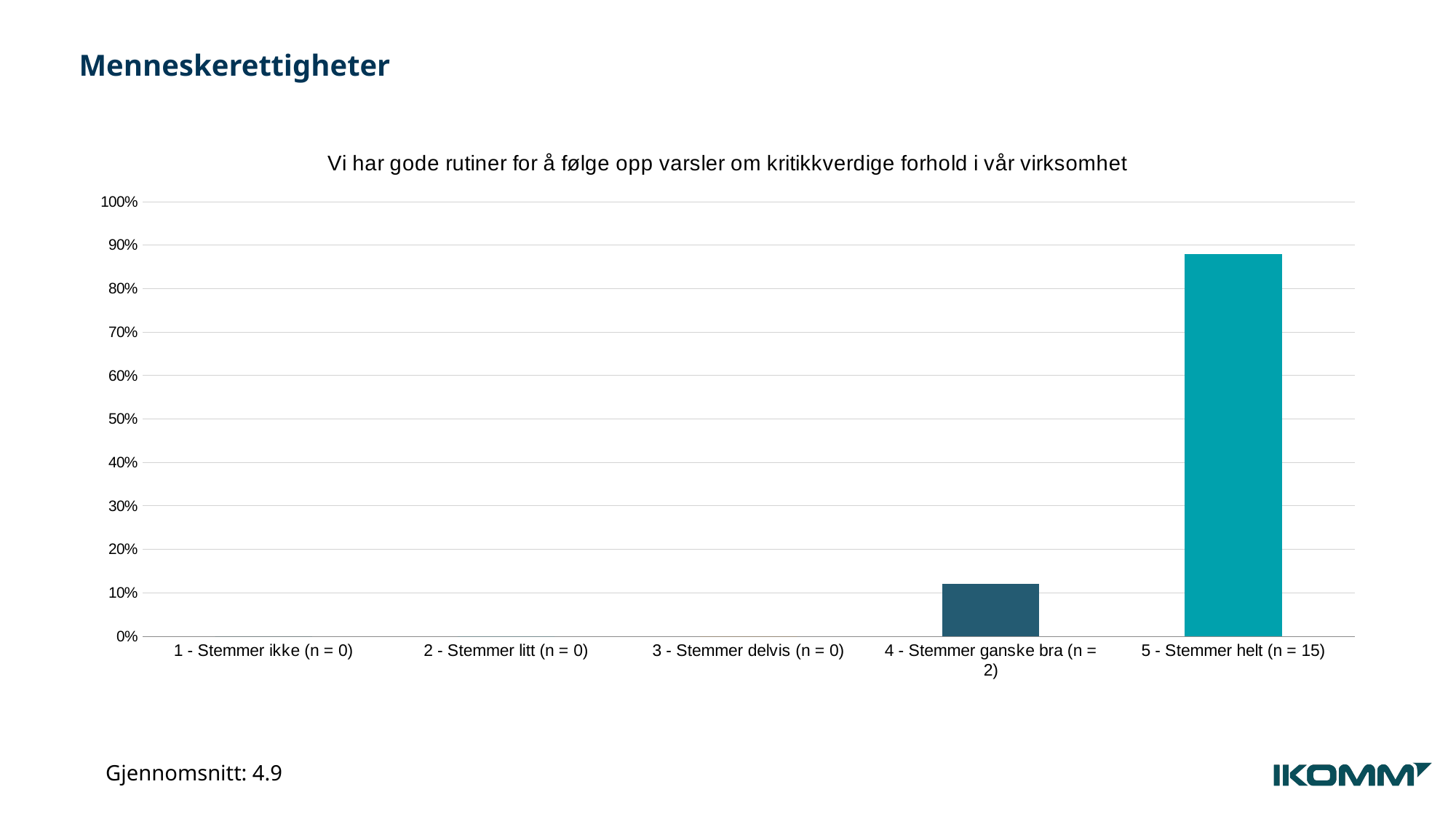
What is the value for 1 - Stemmer ikke in the chart? 0% Is the value for 5 - Stemmer helt greater or less than 80%? greater Which category has the highest value in the chart? 5 - Stemmer helt (n = 15) How many respondents (n) are listed for the category 5 - Stemmer helt? 15 Which is larger, the value for 4 - Stemmer ganske bra or the value for 5 - Stemmer helt? 5 - Stemmer helt Is the value for 5 - Stemmer helt greater or less than 90%? less What is the title of the chart? Vi har gode rutiner for å følge opp varsler om kritikkverdige forhold i vår virksomhet Do the values rise or fall moving from left to right along the x axis? rise What kind of chart is shown on the slide? bar chart Is the value for 4 - Stemmer ganske bra greater or less than 20%? less How many categories are shown on the x axis of the chart? 5